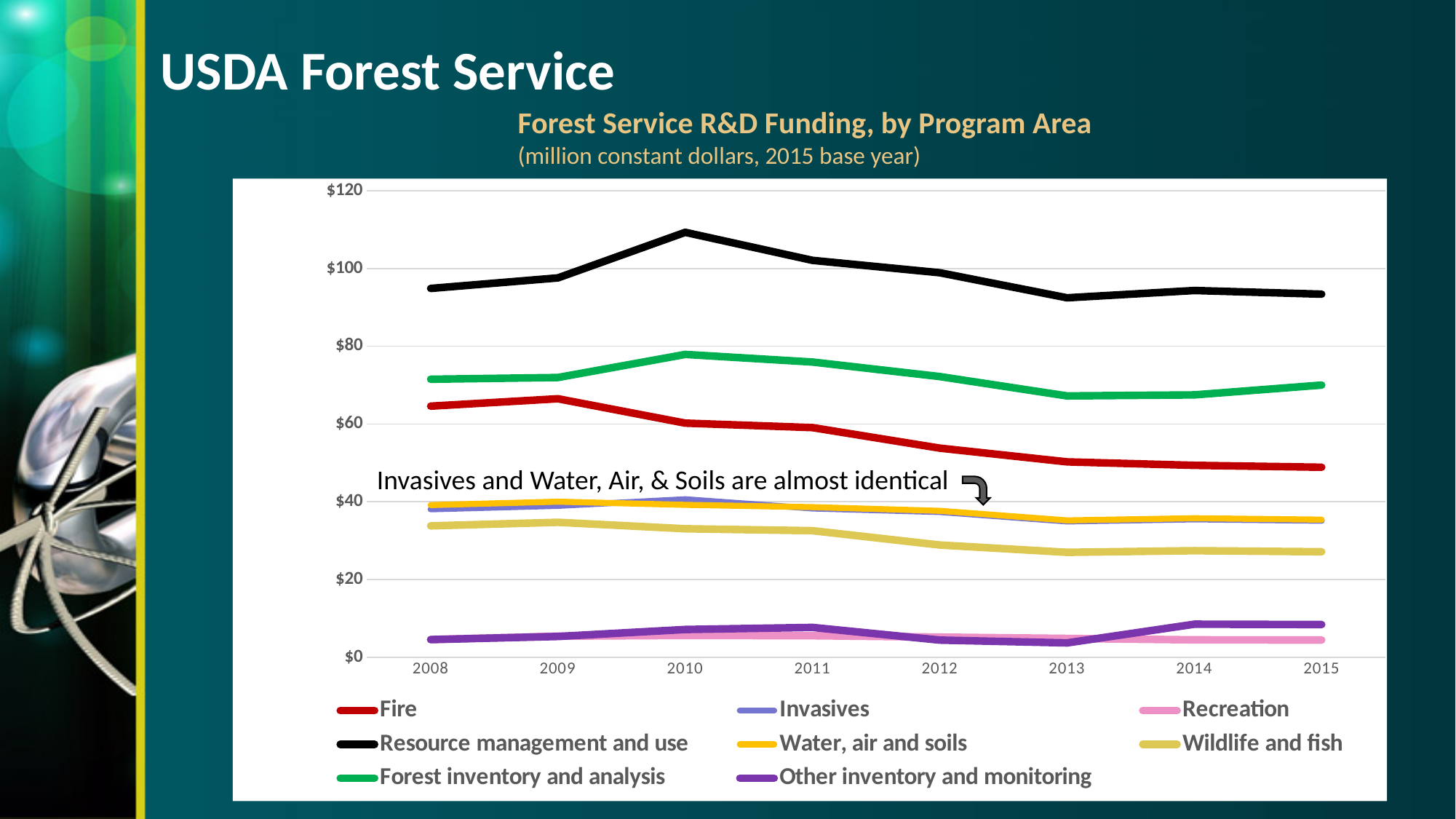
What kind of chart is shown on the slide? line chart Is the value for Forest inventory and analysis in 2013 greater or less than $60? greater How many series does the legend list? 8 Is the value for Fire in 2015 greater or less than $60? less Which program area had the highest funding in 2010? Resource management and use Which program area had the lowest funding in 2015? Recreation Which two series does the annotation on the chart say are almost identical? Invasives and Water, air and soils Does the Fire series rise or fall from 2008 to 2015? fall Is the value for Wildlife and fish in 2008 greater or less than $40? less How many years are shown along the x axis? 8 In 2008, which was larger: Fire or Forest inventory and analysis? Forest inventory and analysis